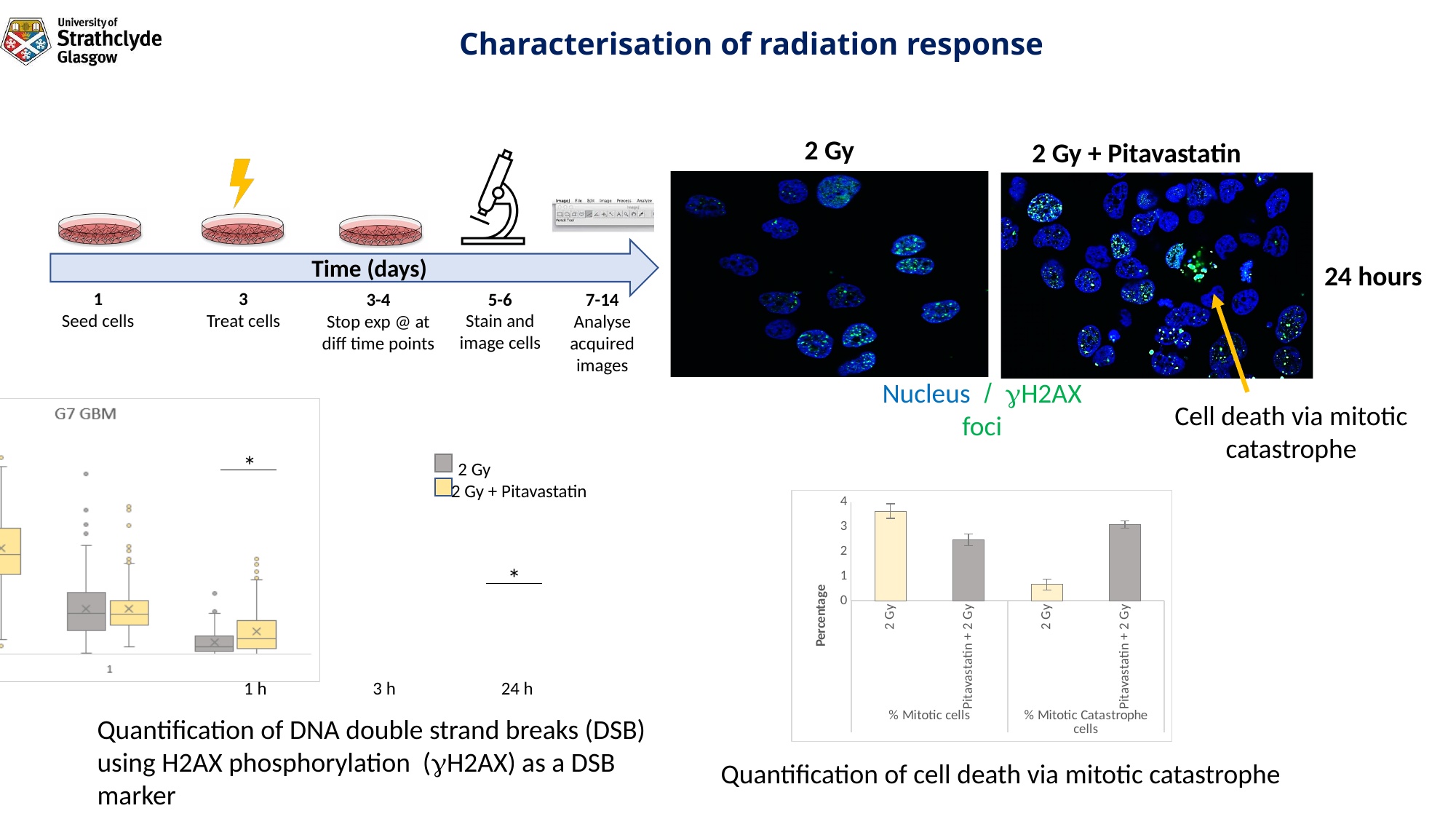
In the bar chart on the right of the slide, under % Mitotic cells, which is larger: 2 Gy or Pitavastatin + 2 Gy? 2 Gy In the box plot on the left of the slide, what is the chart title? G7 GBM In the bar chart on the right of the slide, under % Mitotic Catastrophe cells, which is larger: 2 Gy or Pitavastatin + 2 Gy? Pitavastatin + 2 Gy In the bar chart on the right of the slide, is the value for Pitavastatin + 2 Gy under % Mitotic Catastrophe cells greater or less than 2? greater In the bar chart on the right of the slide, what is the label on the vertical axis? Percentage In the bar chart on the right of the slide, is the value for 2 Gy under % Mitotic Catastrophe cells greater or less than 1? less In the bar chart on the right of the slide, is the value for 2 Gy under % Mitotic cells greater or less than 3? greater In the bar chart on the right of the slide, which bar is the highest? 2 Gy (% Mitotic cells) In the bar chart on the right of the slide, what kind of chart is it? bar chart In the box plot on the left of the slide, how many series does the legend list? 2 In the bar chart on the right of the slide, how many bars are plotted? 4 In the bar chart on the right of the slide, which bar is the lowest? 2 Gy (% Mitotic Catastrophe cells)